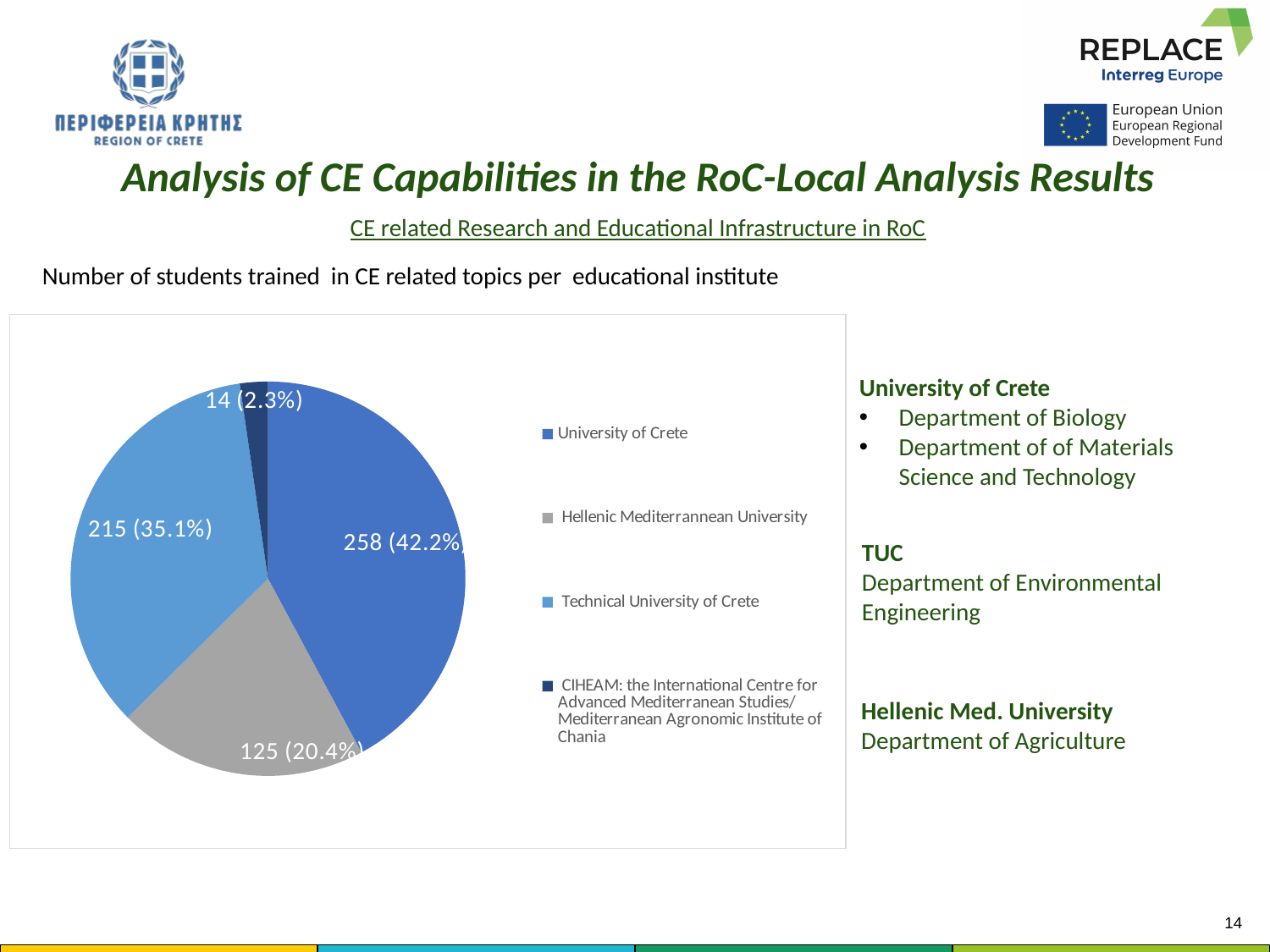
How many institutes are listed in the chart legend? 4 Which institute has the largest share of the pie? University of Crete How many students were trained at CIHEAM? 14 What kind of chart is shown on the slide? pie chart What percentage share of the pie does the Technical University of Crete have? 35.1% How many students were trained at the University of Crete? 258 How many students were trained at the Technical University of Crete? 215 How many students were trained at the Hellenic Mediterranean University? 125 What is the difference in number of students between the University of Crete and the Technical University of Crete? 43 Which institute has the smallest share of the pie? CIHEAM: the International Centre for Advanced Mediterranean Studies/ Mediterranean Agronomic Institute of Chania What percentage share of the pie does the Hellenic Mediterranean University have? 20.4% Which has more students trained, the Hellenic Mediterranean University or the Technical University of Crete? Technical University of Crete